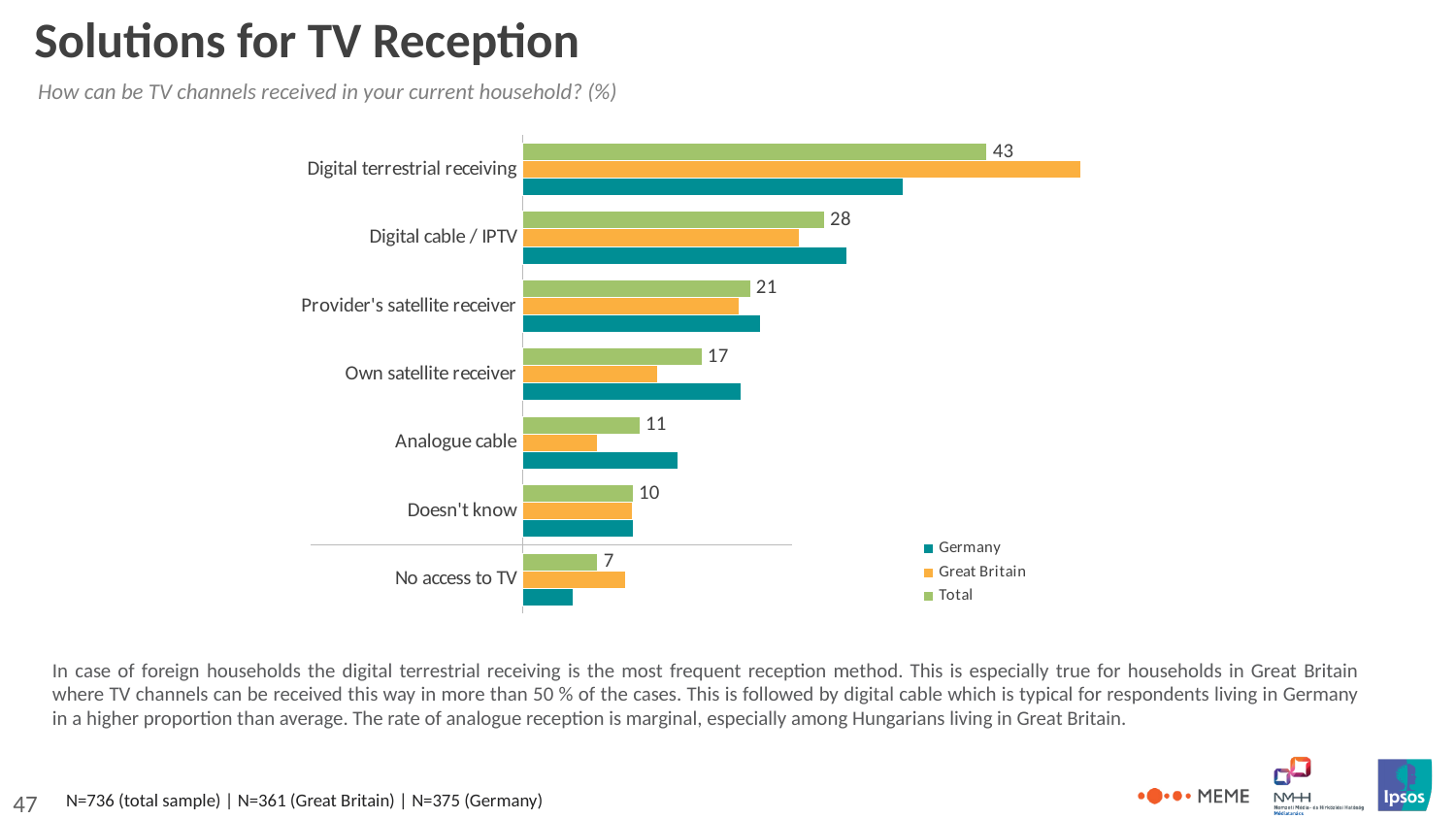
Which category has the highest Total value? Digital terrestrial receiving For Analogue cable, which is larger: the Germany bar or the Great Britain bar? Germany For Digital terrestrial receiving, which is larger: the Germany bar or the Great Britain bar? Great Britain What is the Total value for Digital terrestrial receiving? 43 What is the difference between the Total values for Digital terrestrial receiving and Digital cable / IPTV? 15 What is the Total value for Own satellite receiver? 17 Which category has the lowest Total value? No access to TV How many series does the legend list? 3 What type of chart is shown on the slide? bar chart How many reception categories are shown on the chart? 7 What is the Total value for No access to TV? 7 What is the Total value for Digital cable / IPTV? 28